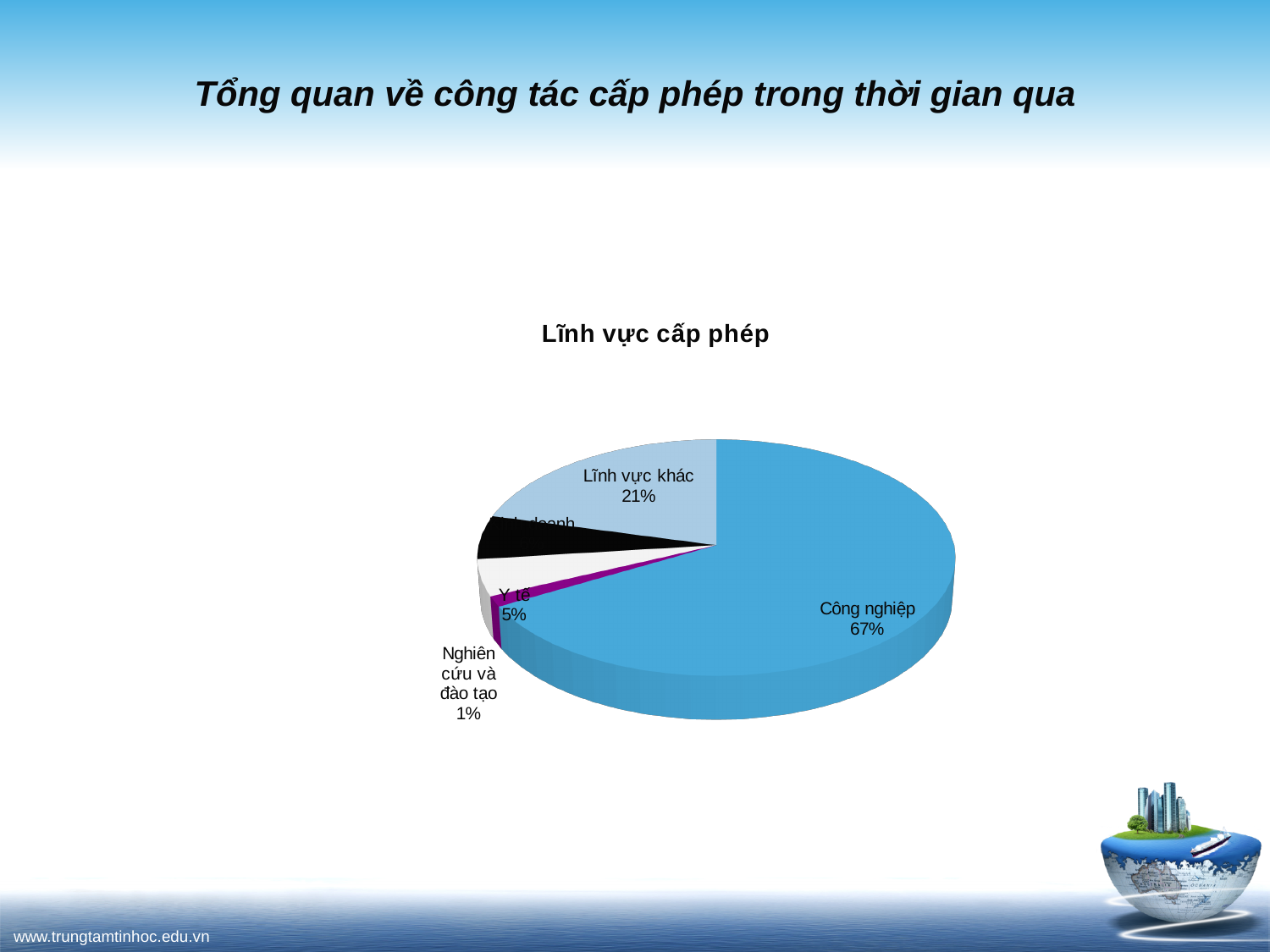
What share of the pie does Nghiên cứu và đào tạo hold? 1% What share of the pie does Y tế hold? 5% What colour is the Công nghiệp slice? Blue How many percentage points larger is Công nghiệp than Lĩnh vực khác? 46 percentage points How many slices does the pie chart have? 5 Which slice is the largest in the pie chart? Công nghiệp What kind of chart is shown on the slide? Pie chart Which slice is the smallest in the pie chart? Nghiên cứu và đào tạo What share of the pie does Công nghiệp hold? 67% Which is larger, the Y tế slice or the Lĩnh vực khác slice? Lĩnh vực khác What share of the pie does Lĩnh vực khác hold? 21% What is the title of the chart? Lĩnh vực cấp phép